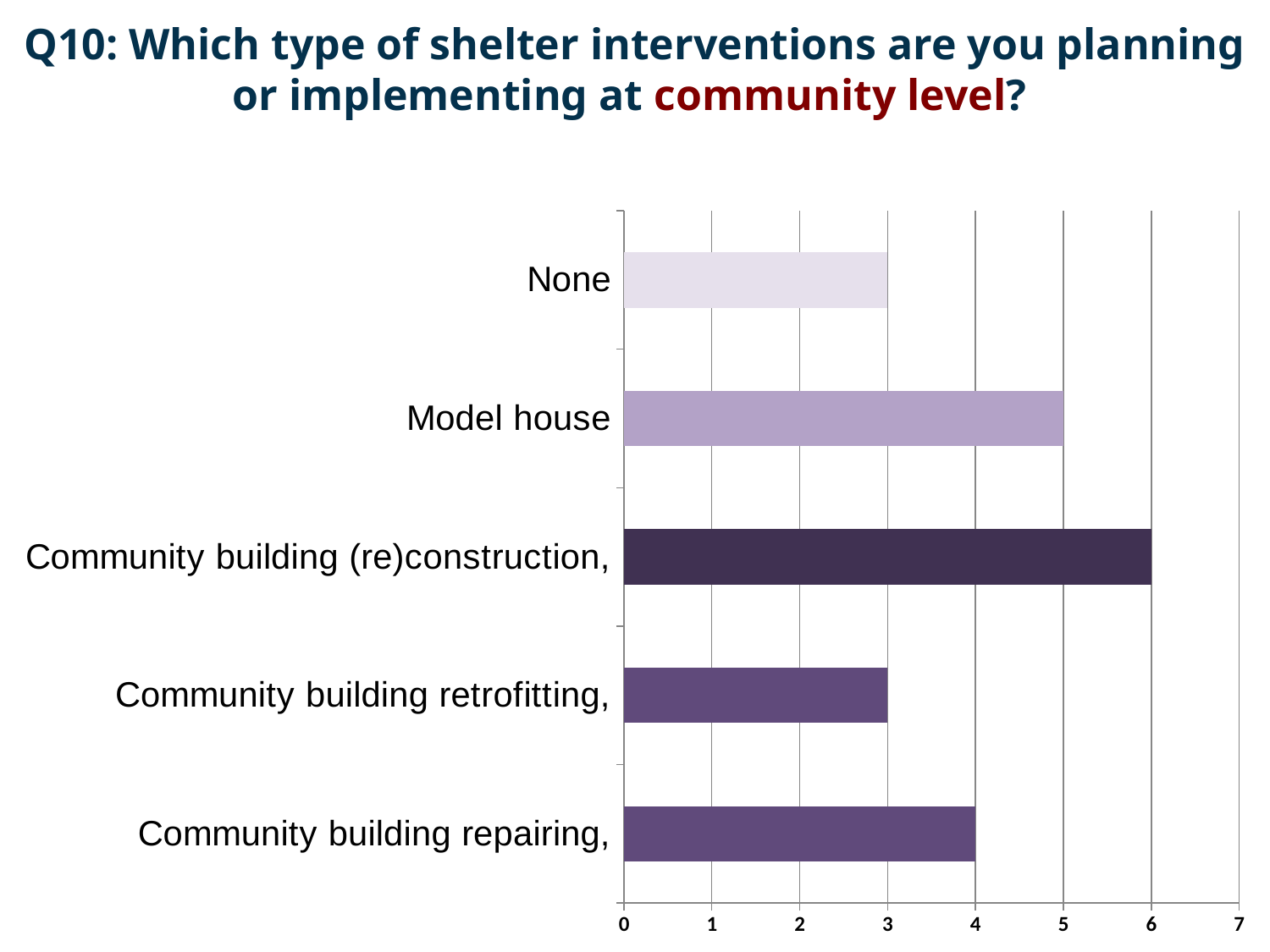
Which two categories share the same value of 3? None and Community building retrofitting What is the value for Community building (re)construction? 6 Is the value for Model house greater or less than 4? greater What is the value for Model house? 5 What is the value for None? 3 Which is larger, the value for Model house or the value for Community building repairing? Model house What is the value for Community building repairing? 4 What type of chart is shown on the slide? bar chart What is the difference between the values for Community building (re)construction and Community building retrofitting? 3 Which category has the highest value? Community building (re)construction What is the highest value shown on the x axis? 7 How many categories are shown in the chart? 5